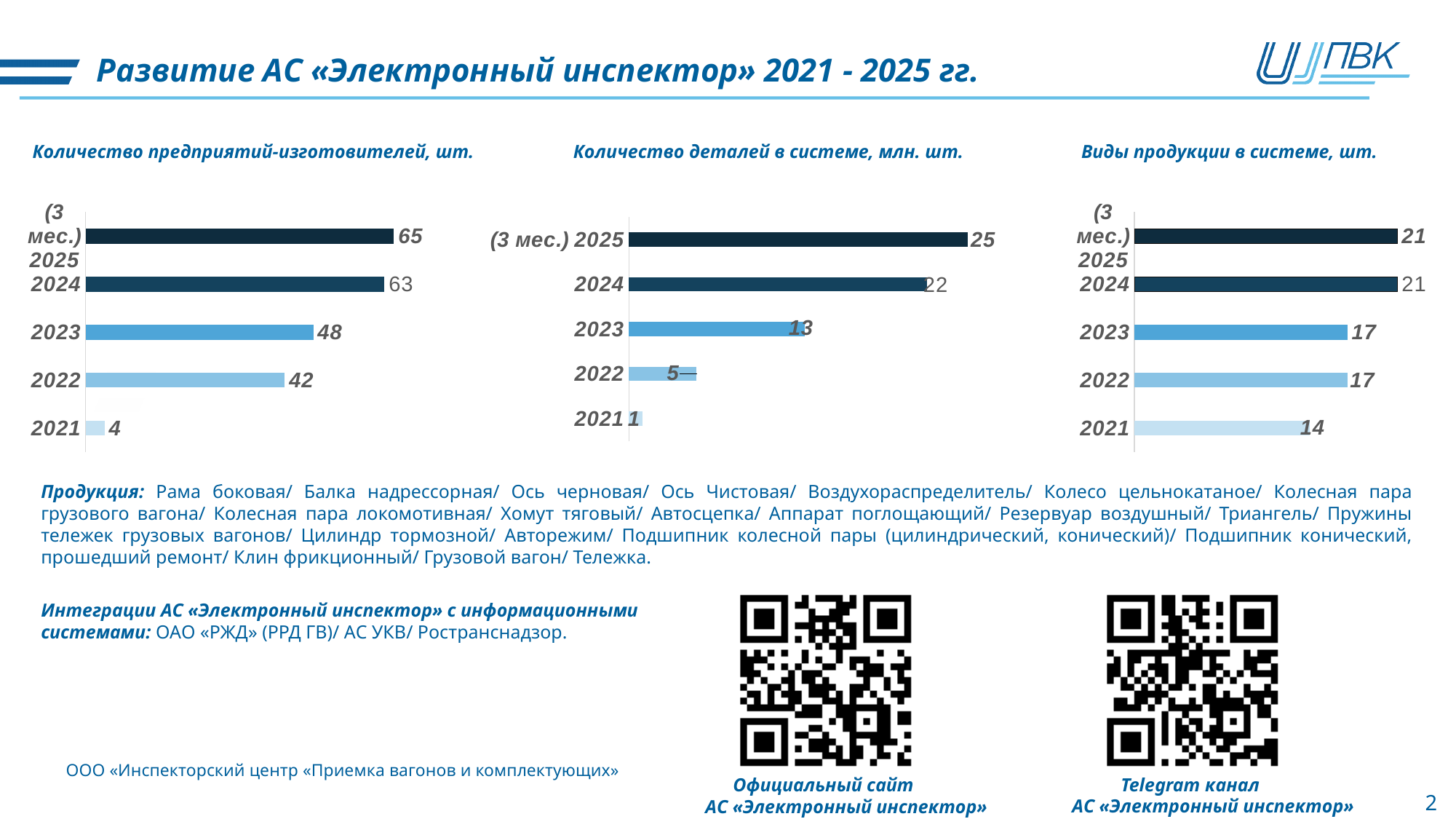
In the chart "Количество предприятий-изготовителей, шт.", what is the difference between the values for 2024 and 2022? 21 In the chart "Количество предприятий-изготовителей, шт.", which year has the highest value? (3 мес.) 2025 What type of chart is "Виды продукции в системе, шт."? bar chart In the chart "Виды продукции в системе, шт.", which is larger, the value for 2023 or the value for 2021? 2023 In the chart "Виды продукции в системе, шт.", what is the difference between the values for 2024 and 2023? 4 In the chart "Количество предприятий-изготовителей, шт.", what is the value for 2023? 48 In the chart "Виды продукции в системе, шт.", what is the value for 2021? 14 In the chart "Количество деталей в системе, млн. шт.", how many bars are plotted? 5 In the chart "Количество деталей в системе, млн. шт.", which year has the lowest value? 2021 In the chart "Количество деталей в системе, млн. шт.", what is the value for 2024? 22 In the chart "Количество деталей в системе, млн. шт.", do the values rise or fall from 2021 to 2025? rise In the chart "Количество предприятий-изготовителей, шт.", what is the value for 2021? 4